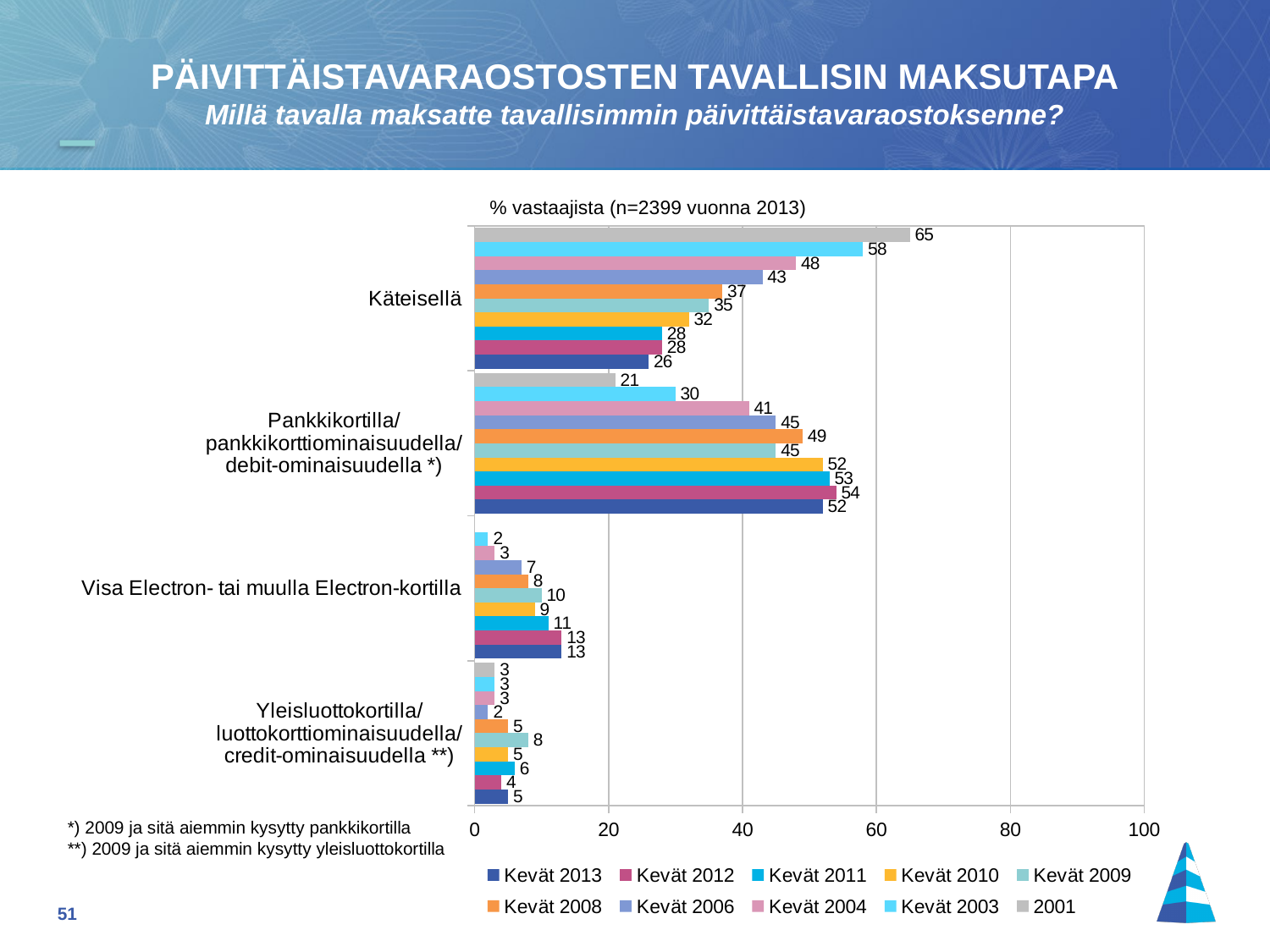
What is the difference between the Käteisellä values for 2001 and Kevät 2013? 39 How many series does the legend list? 10 Which series has the highest value for Käteisellä? 2001 Across the series from 2001 to Kevät 2013, do the values for Käteisellä rise or fall? fall Which series has the lowest value for Pankkikortilla/pankkikorttiominaisuudella/debit-ominaisuudella? 2001 What is the value for Visa Electron- tai muulla Electron-kortilla in the Kevät 2009 series? 10 What is the value for Pankkikortilla/pankkikorttiominaisuudella/debit-ominaisuudella in the Kevät 2012 series? 54 How many payment-method categories are shown on the y axis? 4 What is the value for Käteisellä in the Kevät 2013 series? 26 For the Kevät 2013 series, which is larger: Käteisellä or Pankkikortilla/pankkikorttiominaisuudella/debit-ominaisuudella? Pankkikortilla/pankkikorttiominaisuudella/debit-ominaisuudella What kind of chart is shown on the slide? bar chart What is the value for Käteisellä in the 2001 series? 65